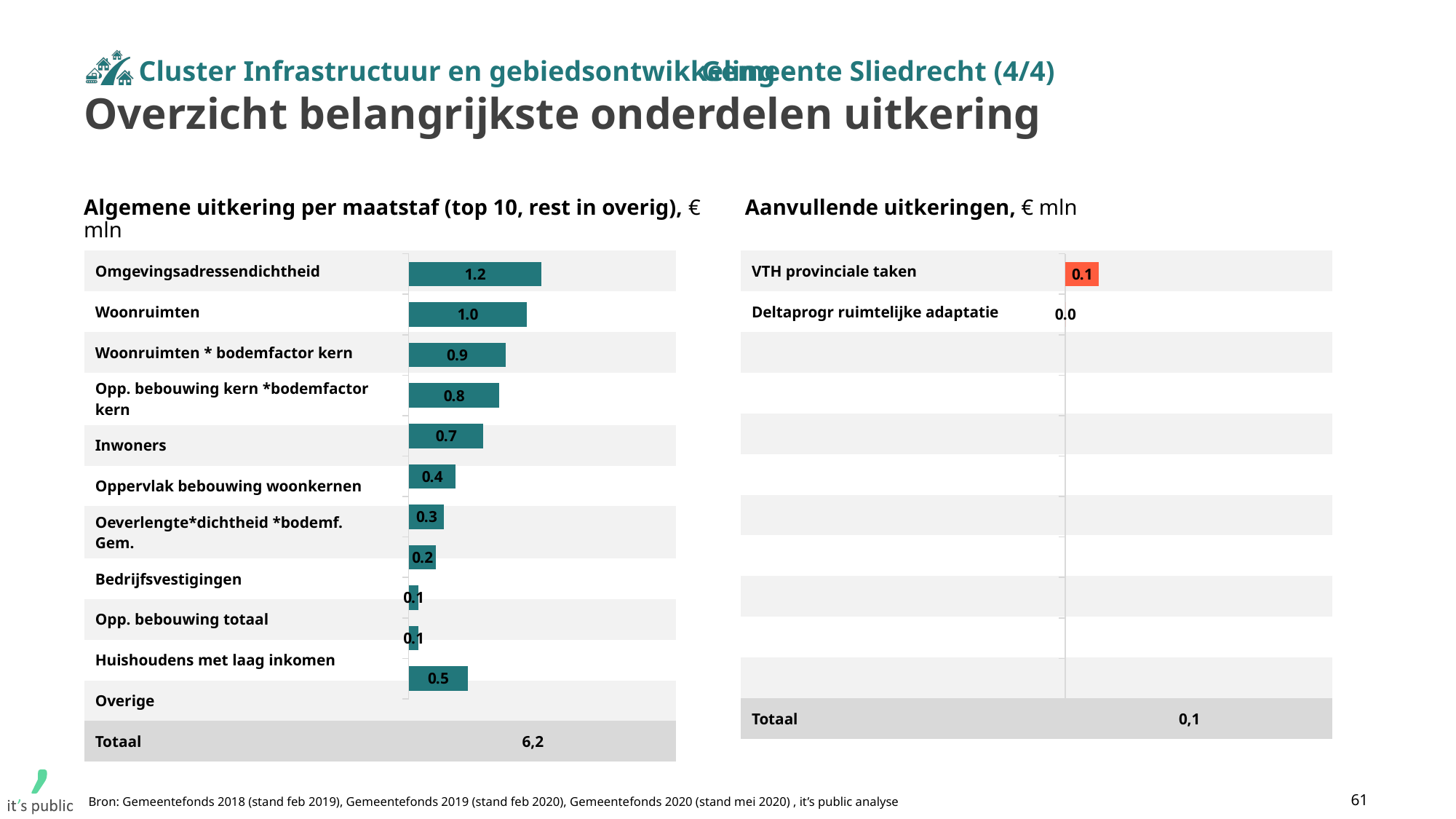
What kind of chart is the 'Aanvullende uitkeringen' chart? Bar chart How many categories (including Overige) are shown in the 'Algemene uitkering per maatstaf' chart? 11 In the 'Aanvullende uitkeringen' chart, what is the value for Deltaprogr ruimtelijke adaptatie? 0.0 In the 'Aanvullende uitkeringen' chart, what is the value for VTH provinciale taken? 0.1 In the 'Algemene uitkering per maatstaf' chart, what is the value for Overige? 0.5 In the 'Algemene uitkering per maatstaf' chart, what is the difference between Woonruimten and Oppervlak bebouwing woonkernen? 0.6 In the 'Algemene uitkering per maatstaf' chart, what is the value for Inwoners? 0.7 What is the Totaal shown for the 'Algemene uitkering per maatstaf' chart? 6,2 In the 'Algemene uitkering per maatstaf' chart, which category has the highest value? Omgevingsadressendichtheid In the 'Algemene uitkering per maatstaf' chart, what is the value for Omgevingsadressendichtheid? 1.2 What is the Totaal shown for the 'Aanvullende uitkeringen' chart? 0,1 In the 'Algemene uitkering per maatstaf' chart, which is larger: Woonruimten * bodemfactor kern or Bedrijfsvestigingen? Woonruimten * bodemfactor kern